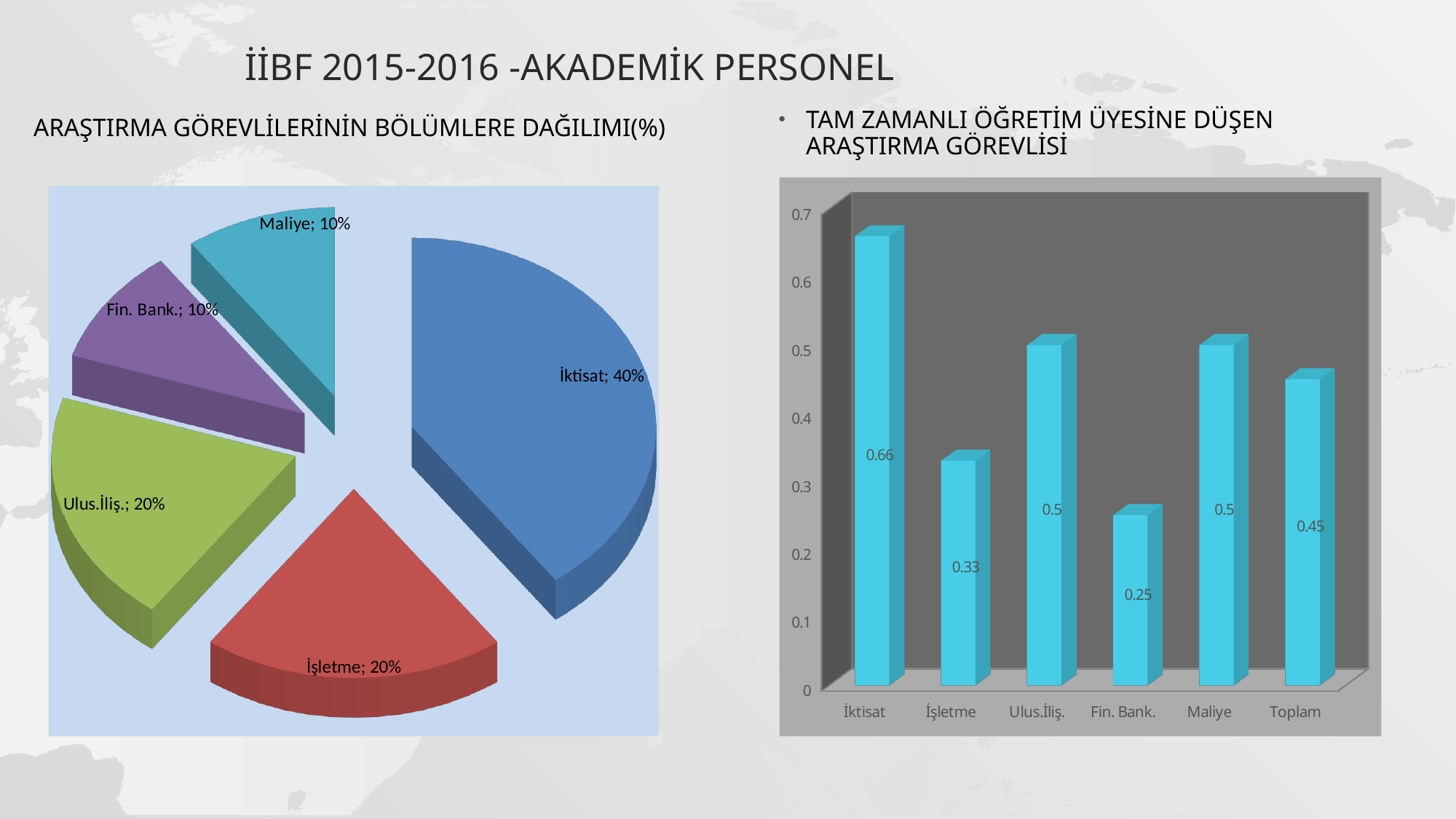
In the bar chart on the right, how many categories are shown on the x axis? 6 In the pie chart on the left, what share does İktisat have? 40% In the bar chart on the right, what is the difference between the values for İktisat and Toplam? 0.21 In the bar chart on the right, which is larger, the value for İşletme or the value for Maliye? Maliye In the bar chart on the right, what is the value for İktisat? 0.66 In the pie chart on the left, which department has the largest share? İktisat What type of chart is shown on the right side of the slide? Bar chart In the bar chart on the right, which category has the lowest value? Fin. Bank. In the bar chart on the right, which category has the highest value? İktisat In the pie chart on the left, what share does Fin. Bank. have? 10% In the pie chart on the left, what is the difference between the shares of İktisat and İşletme? 20% In the pie chart on the left, how many slices are there? 5